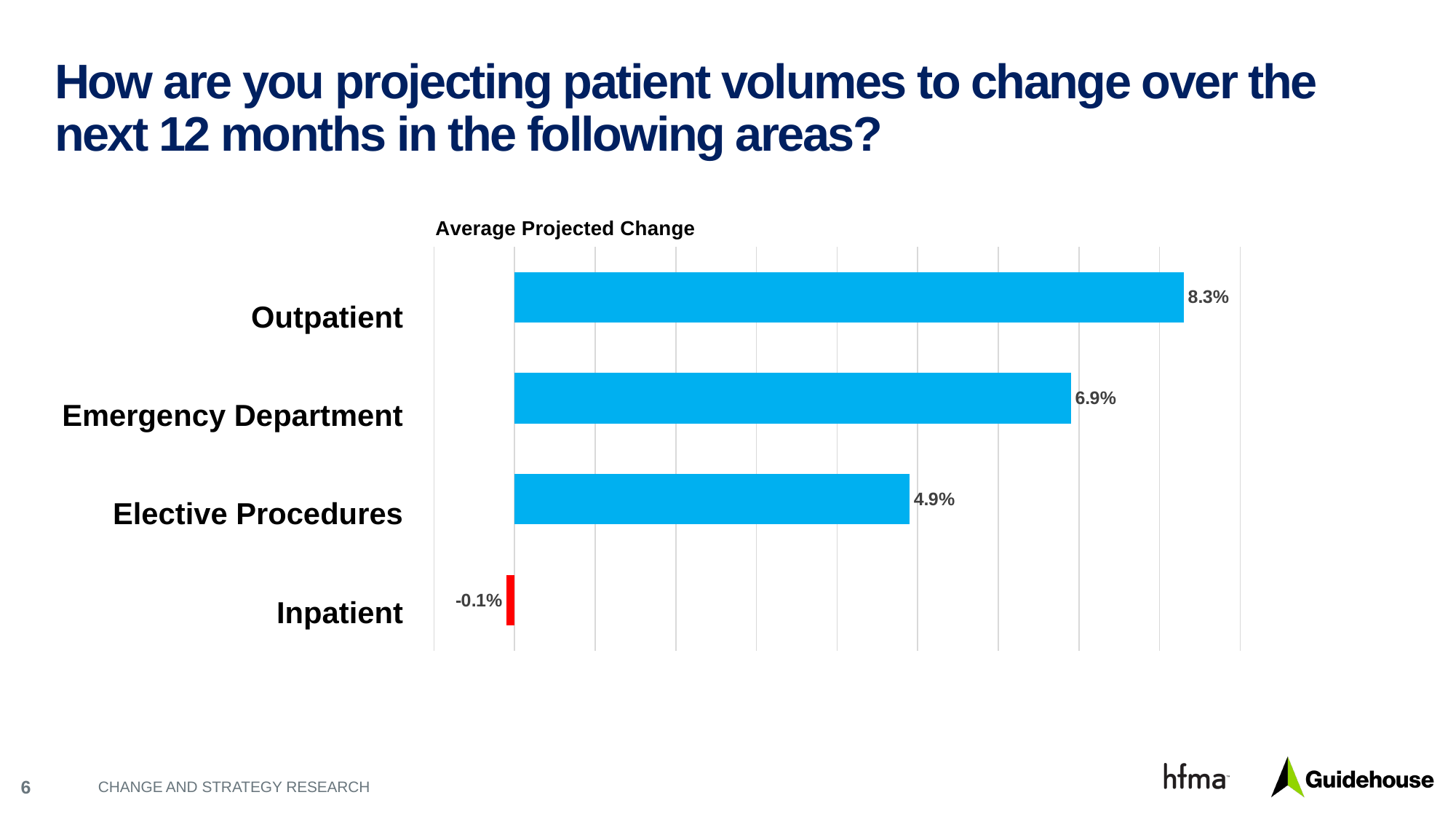
What is the title of the chart? Average Projected Change What is the difference between the average projected change for Outpatient and Emergency Department? 1.4% What is the difference between the average projected change for Emergency Department and Elective Procedures? 2.0% How many areas are shown in the chart? 4 Which area has the lowest average projected change? Inpatient What kind of chart is shown on the slide? Bar chart What is the average projected change for Outpatient? 8.3% What is the average projected change for Emergency Department? 6.9% Which area has the highest average projected change? Outpatient What is the average projected change for Inpatient? -0.1% What is the average projected change for Elective Procedures? 4.9% Which has a larger average projected change, Elective Procedures or Emergency Department? Emergency Department